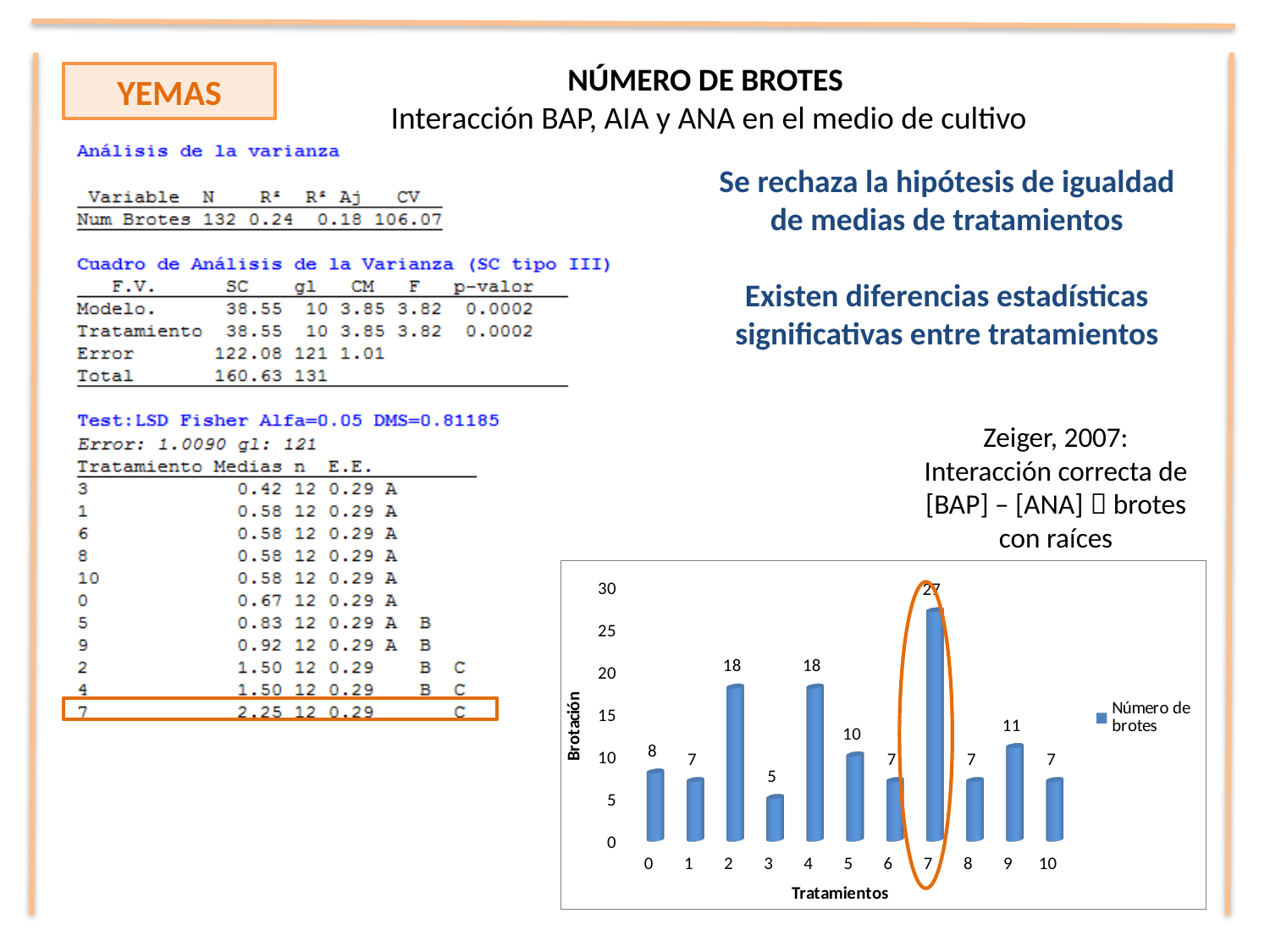
Is the value for treatment 7 greater or less than 25? greater Which treatment has the lowest number of brotes? 3 What is the difference between the values for treatment 7 and treatment 4? 9 What is the value for treatment 5 in the chart? 10 What is the value for treatment 7 in the chart? 27 What is the value for treatment 2 in the chart? 18 What is the label of the x axis of the chart? Tratamientos How many series does the chart legend list? 1 What type of chart is shown on the slide? bar chart Which treatment has the highest number of brotes? 7 Which is larger, the value for treatment 9 or the value for treatment 5? treatment 9 How many treatments are shown on the x axis of the chart? 11